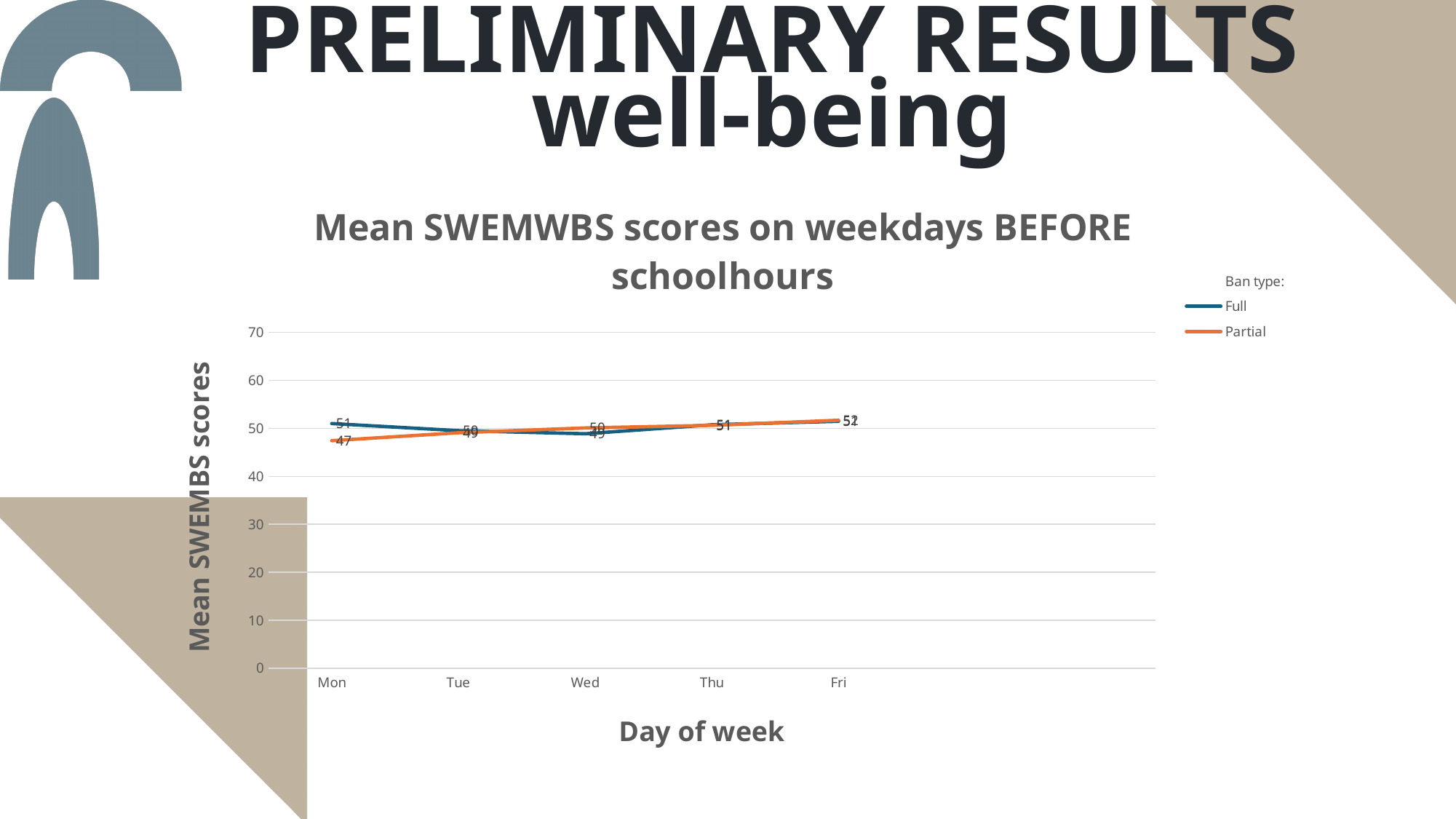
On Mon, which ban type has the higher mean SWEMWBS score, Full or Partial? Full What is the mean SWEMWBS score for the Full ban type on Thu? 51 What is the mean SWEMWBS score for the Full ban type on Wed? 49 What is the title of the legend on the chart? Ban type: What is the mean SWEMWBS score for the Full ban type on Mon? 51 What type of chart is shown on the slide? line chart How many days of the week are plotted on the x axis? 5 Is the Partial ban type's score on Fri greater or less than 40? greater What is the mean SWEMWBS score for the Partial ban type on Mon? 47 How many series does the legend list? 2 What is the difference between the Full and Partial scores on Mon? 4 What is the mean SWEMWBS score for the Partial ban type on Wed? 50